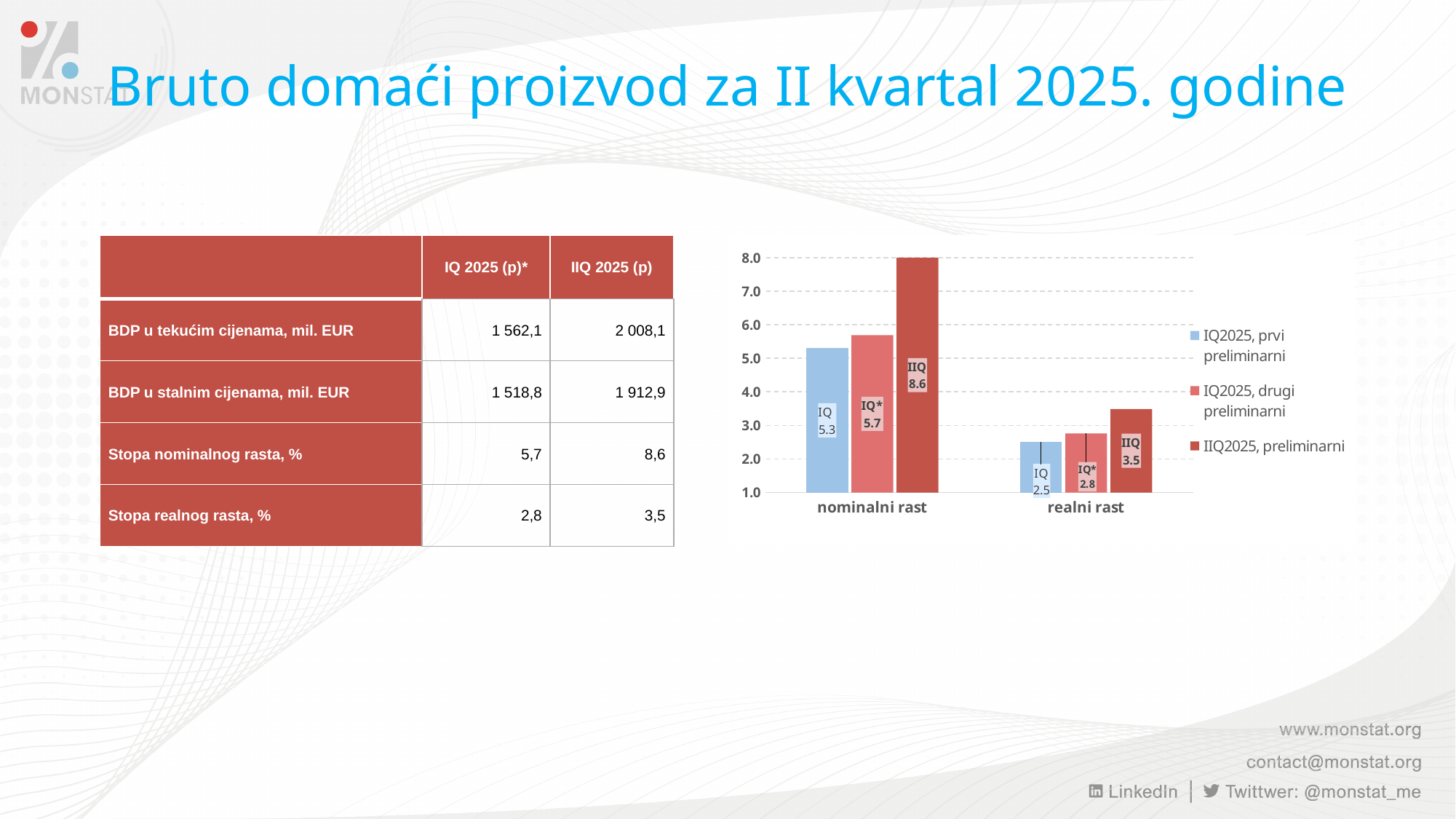
How many categories are shown on the x axis of the chart? 2 What is the value of the IQ2025, prvi preliminarni bar for realni rast? 2.5 What is the difference between the IIQ2025, preliminarni and IQ2025, drugi preliminarni values for nominalni rast? 2.9 What is the value of the IQ2025, drugi preliminarni bar for nominalni rast? 5.7 What is the value of the IIQ2025, preliminarni bar for nominalni rast? 8.6 Which is larger for realni rast: the IQ2025, drugi preliminarni value or the IIQ2025, preliminarni value? IIQ2025, preliminarni What colour are the IIQ2025, preliminarni bars in the chart? dark red How many series does the chart legend list? 3 What is the value of the IIQ2025, preliminarni bar for realni rast? 3.5 Which bar in the chart has the highest value? IIQ2025, preliminarni for nominalni rast What type of chart is shown on the slide? bar chart Which bar in the chart has the lowest value? IQ2025, prvi preliminarni for realni rast